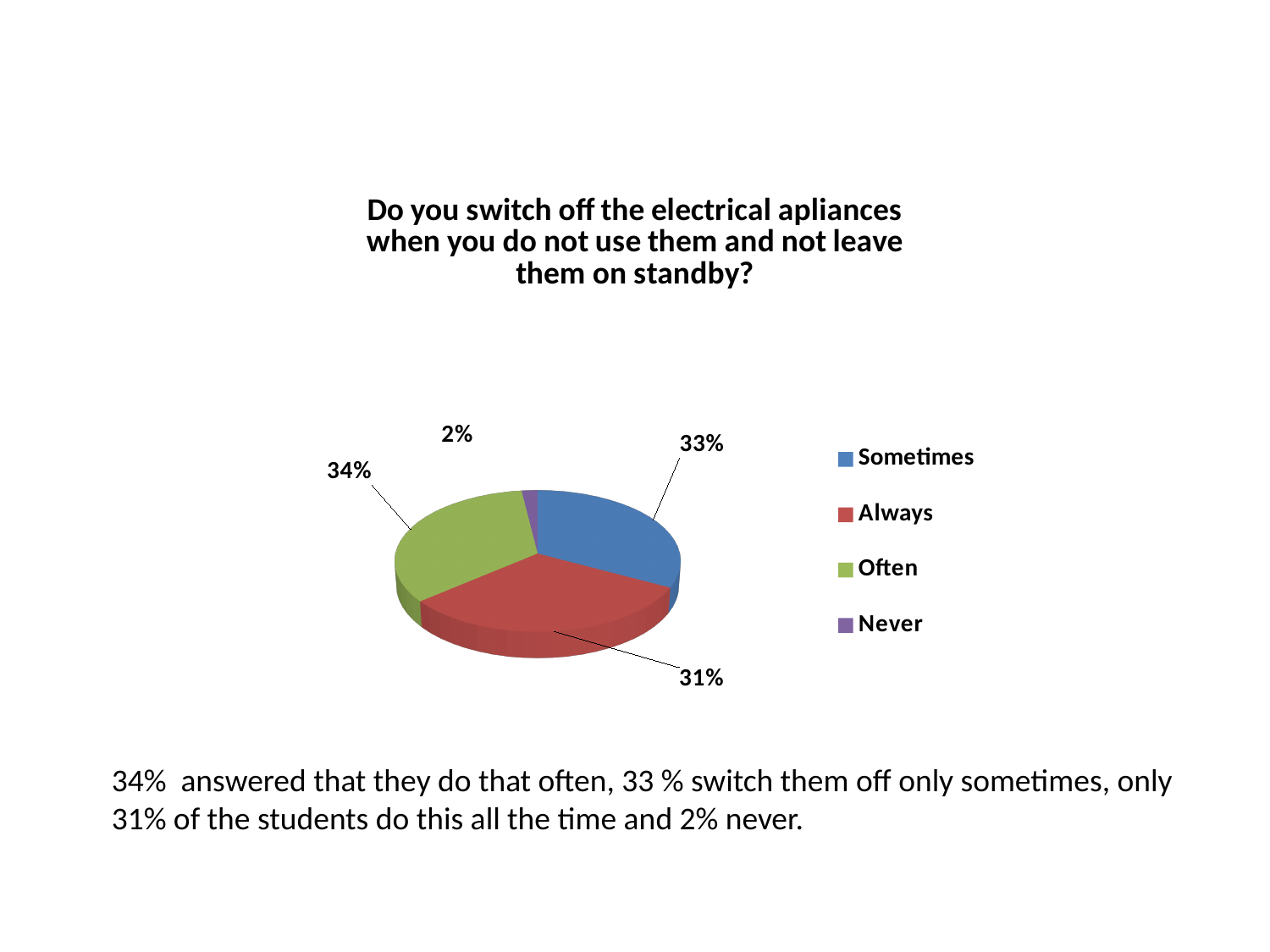
What percentage of respondents answered "Never"? 2% What percentage of respondents answered "Always"? 31% Which slice is larger, "Sometimes" or "Always"? Sometimes What colour is the "Often" slice in the pie chart? Green What type of chart is shown on the slide? Pie chart What percentage of respondents answered "Often"? 34% Which response has the smallest share of the pie? Never How many categories does the pie chart show? 4 Which response has the largest share of the pie? Often What is the difference in percentage points between the "Often" and "Never" slices? 32 What percentage of respondents answered "Sometimes"? 33% Which legend entry is listed first? Sometimes